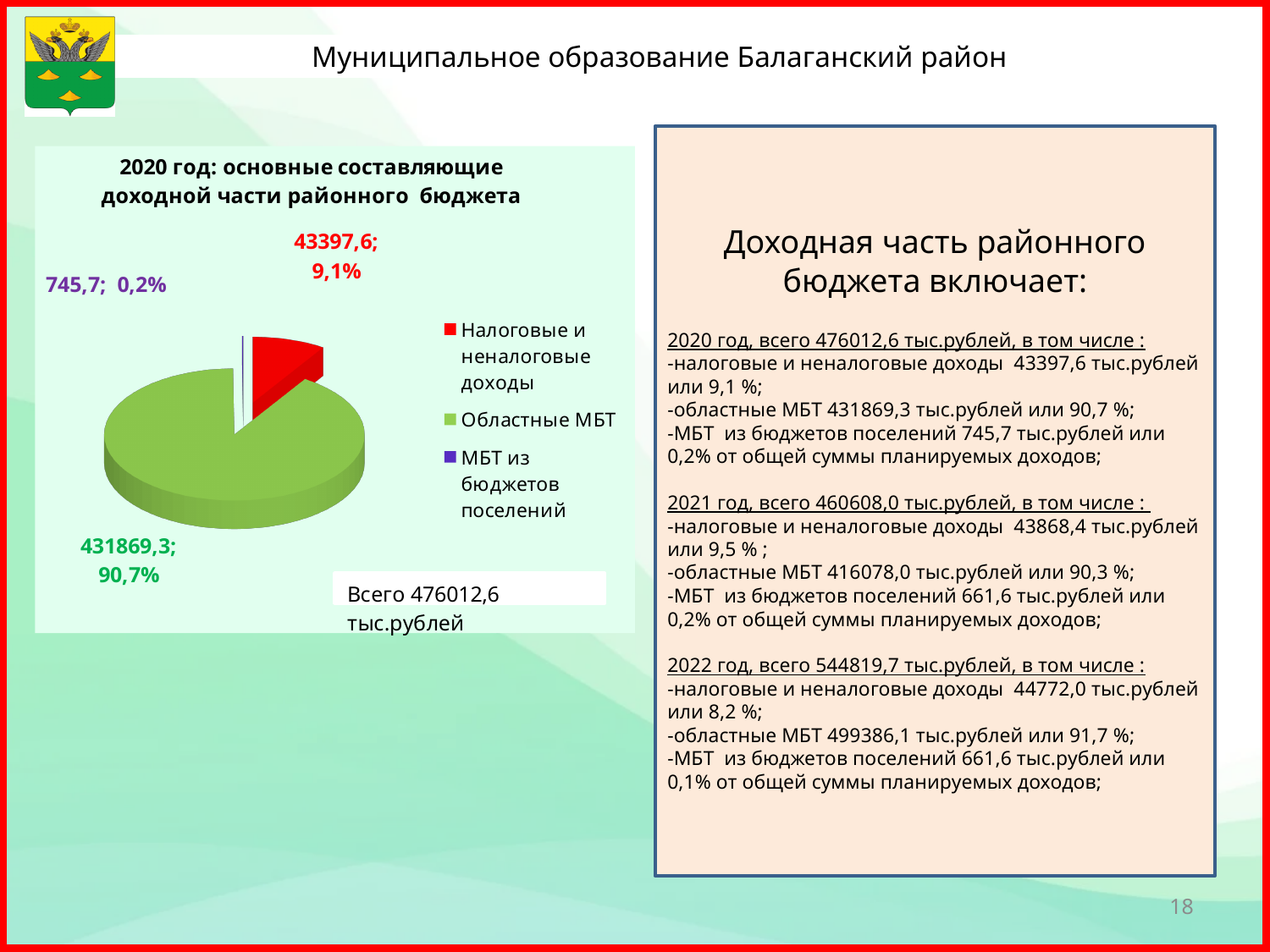
What is the value shown for "Областные МБТ" in the pie chart? 431869,3 What is the difference between the values for "Областные МБТ" and "Налоговые и неналоговые доходы" in the pie chart? 388471,7 How many entries does the legend of the pie chart list? 3 What share of the pie does "Налоговые и неналоговые доходы" represent? 9,1% What total is stated below the pie chart? Всего 476012,6 тыс.рублей Which category has the smallest slice in the pie chart? МБТ из бюджетов поселений What share of the pie does "МБТ из бюджетов поселений" represent? 0,2% What type of chart is shown on the slide? Pie chart What is the value shown for "Налоговые и неналоговые доходы" in the pie chart? 43397,6 Which is larger in the pie chart: "Налоговые и неналоговые доходы" or "МБТ из бюджетов поселений"? Налоговые и неналоговые доходы Which category has the largest slice in the pie chart? Областные МБТ How many slices does the pie chart have? 3